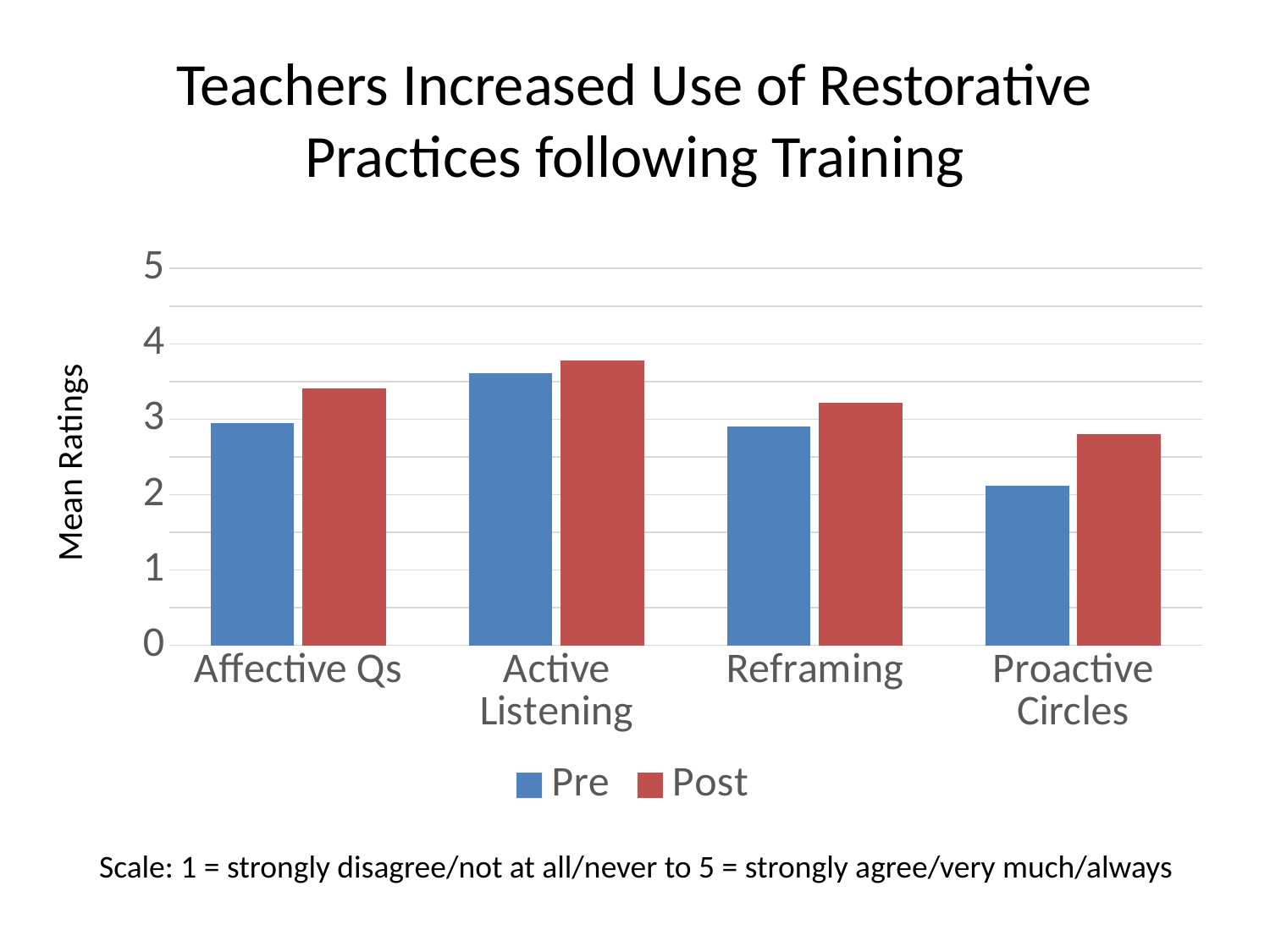
Is the Post value for Active Listening greater or less than 4? less For Proactive Circles, which is larger, the Pre or the Post rating? Post Which category has the lowest Pre rating? Proactive Circles What is the label on the y axis? Mean Ratings For Affective Qs, which is larger, the Pre or the Post rating? Post Is the Post value for Proactive Circles greater or less than 3? less What kind of chart is shown on the slide? bar chart Which series is shown in red? Post How many series does the legend list? 2 Which category has the highest Post rating? Active Listening Is the Pre value for Active Listening greater or less than 3? greater How many categories are shown on the x axis? 4